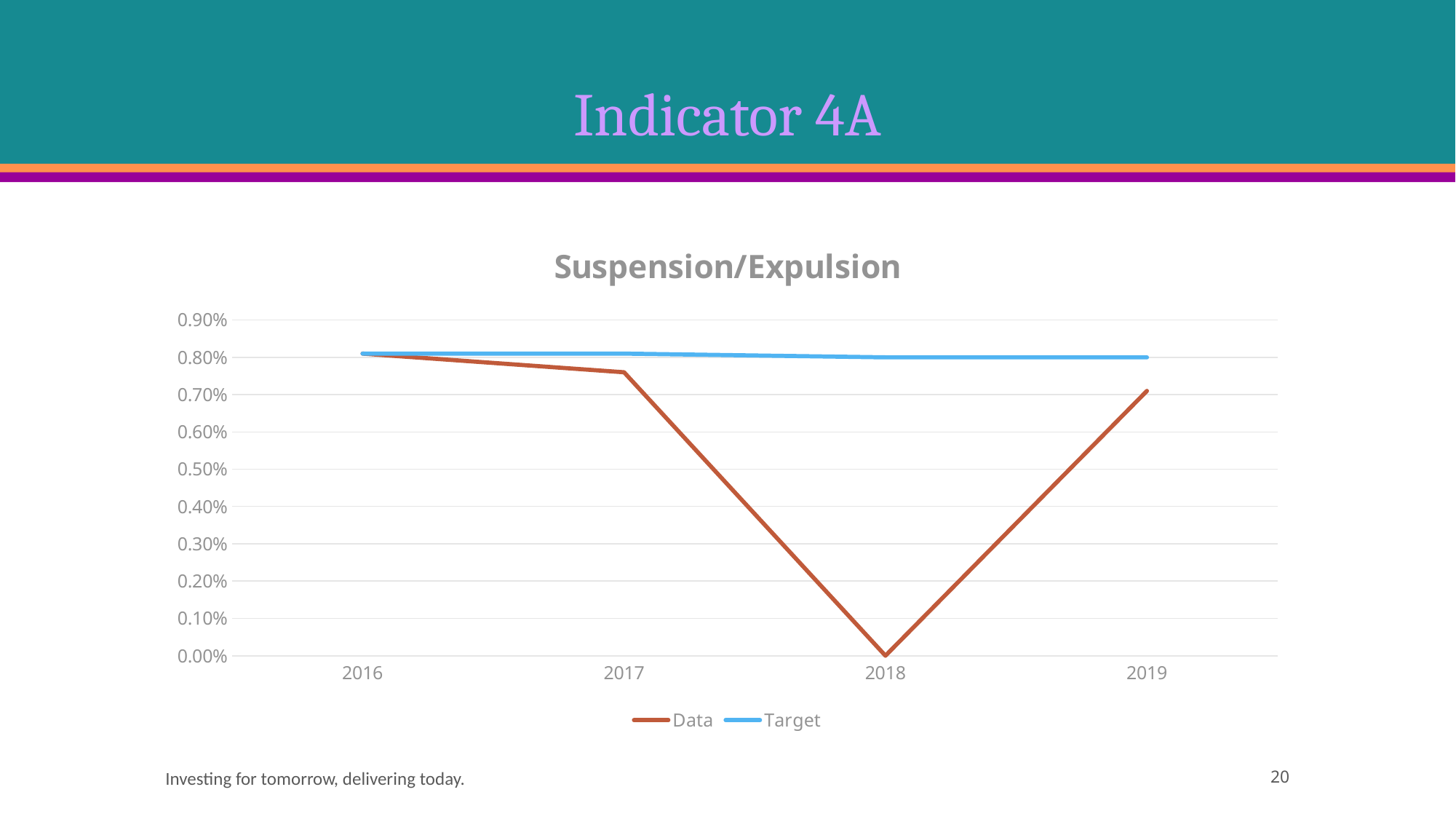
Is the value of the Data series in 2019 greater or less than 0.80%? less How many series does the legend list? 2 Is the value of the Data series in 2017 greater or less than 0.70%? greater In which year is the Data series at its highest? 2016 How many years are shown on the x axis? 4 What kind of chart is shown on the slide? line chart What is the value of the Data series in 2018? 0.00% In 2019, which series has the larger value, Data or Target? Target Does the Data series rise or fall between 2018 and 2019? rise What is the title of the chart? Suspension/Expulsion Which series are listed in the legend? Data, Target In which year is the Data series at its lowest? 2018